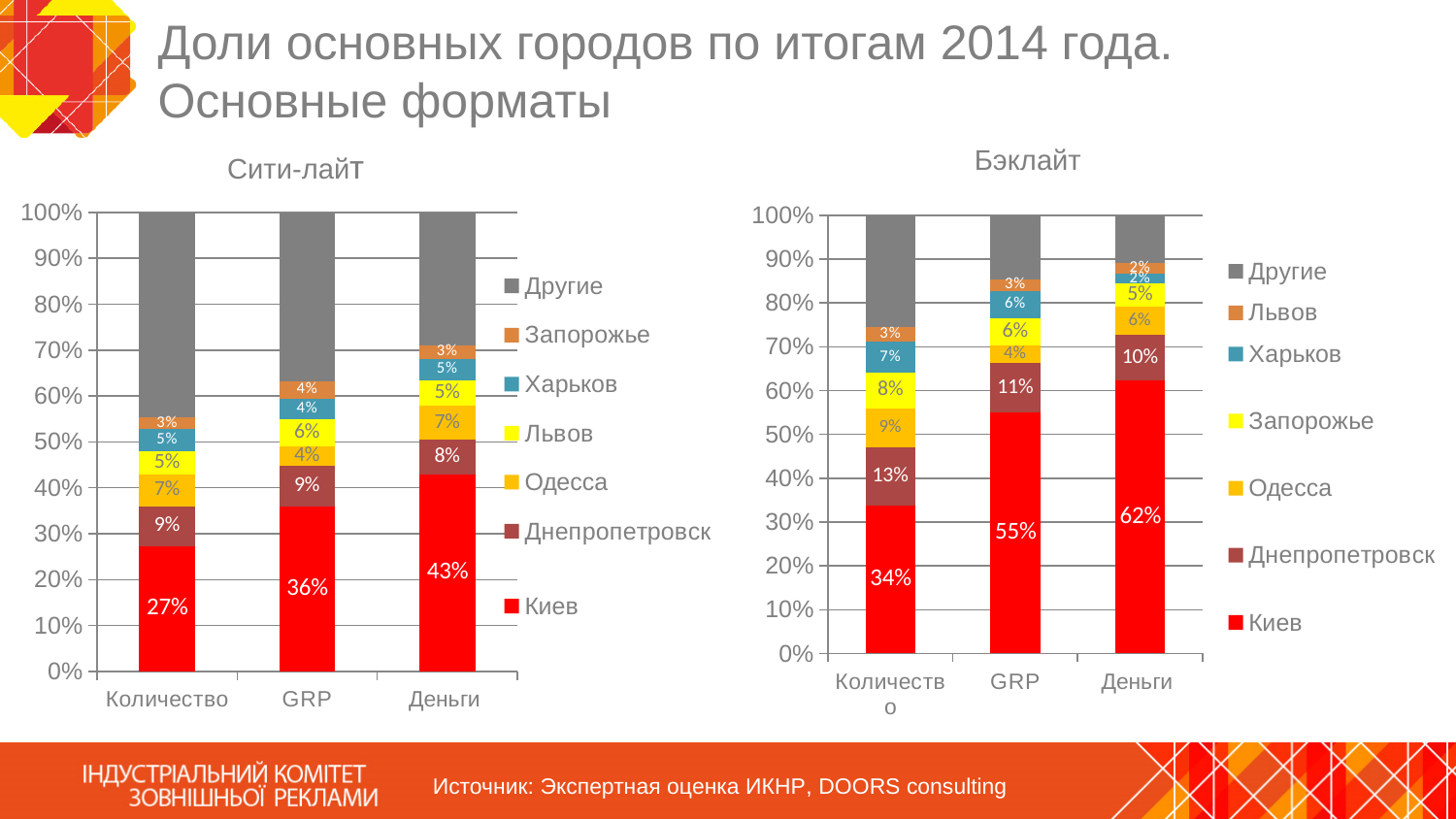
In the Бэклайт chart, what is the difference between the Киев values for GRP and Количество? 21% In the Сити-лайт chart, which category has the lowest value for Киев? Количество In the Сити-лайт chart, what is the difference between the Киев values for Деньги and Количество? 16% In the Сити-лайт chart, what is the value for Днепропетровск in the GRP bar? 9% How many series does the legend of the Бэклайт chart list? 7 Which is larger: the Киев value for GRP in the Сити-лайт chart or the Киев value for GRP in the Бэклайт chart? Бэклайт In the Сити-лайт chart, what is the value for Киев in the Количество bar? 27% How many categories are shown on the x axis of the Сити-лайт chart? 3 In the Бэклайт chart, what is the value for Днепропетровск in the Количество bar? 13% In the Бэклайт chart, what is the value for Киев in the Деньги bar? 62% What kind of chart is the Сити-лайт chart? Stacked bar chart In the Бэклайт chart, which category has the highest value for Киев? Деньги